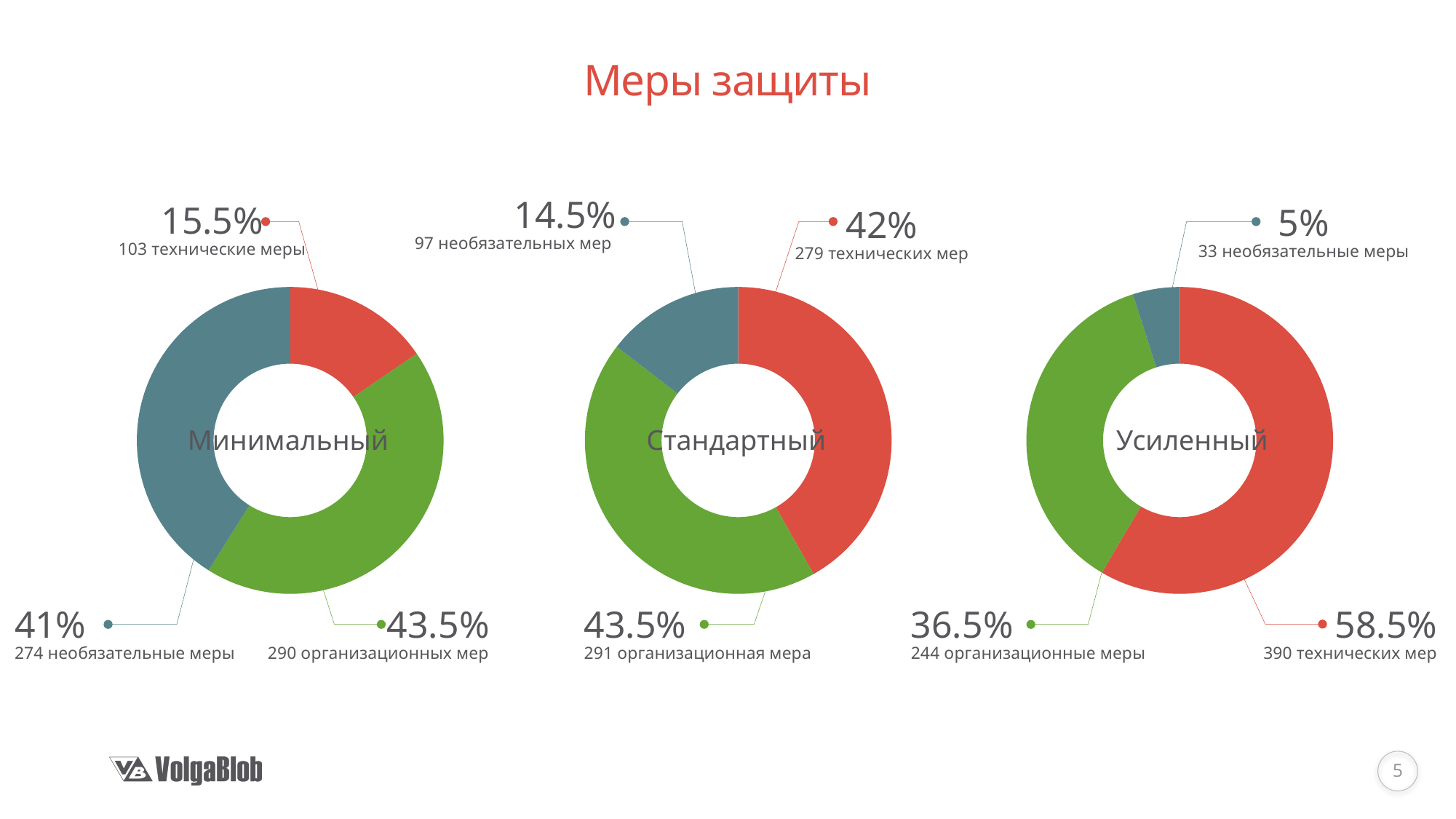
Which is larger in the Усиленный chart: the share of организационные меры or the share of необязательные меры? организационные меры In the Усиленный chart, what is the difference in share between технические меры and организационные меры? 22% In the Минимальный chart, which category has the largest share? организационные меры (43.5%) What kind of charts are shown on the slide? Pie (donut) charts In the Стандартный chart, which category has the smallest share? необязательные меры (14.5%) In the Стандартный chart, how many технических мер are there? 279 How many donut charts are on the slide? 3 What is the title of the slide? Меры защиты In the Стандартный chart, what share do необязательные меры have? 14.5% In the Усиленный chart, what share do технические меры have? 58.5% In the Минимальный chart, how many необязательные меры are there? 274 In the Минимальный chart, what share do технические меры have? 15.5%